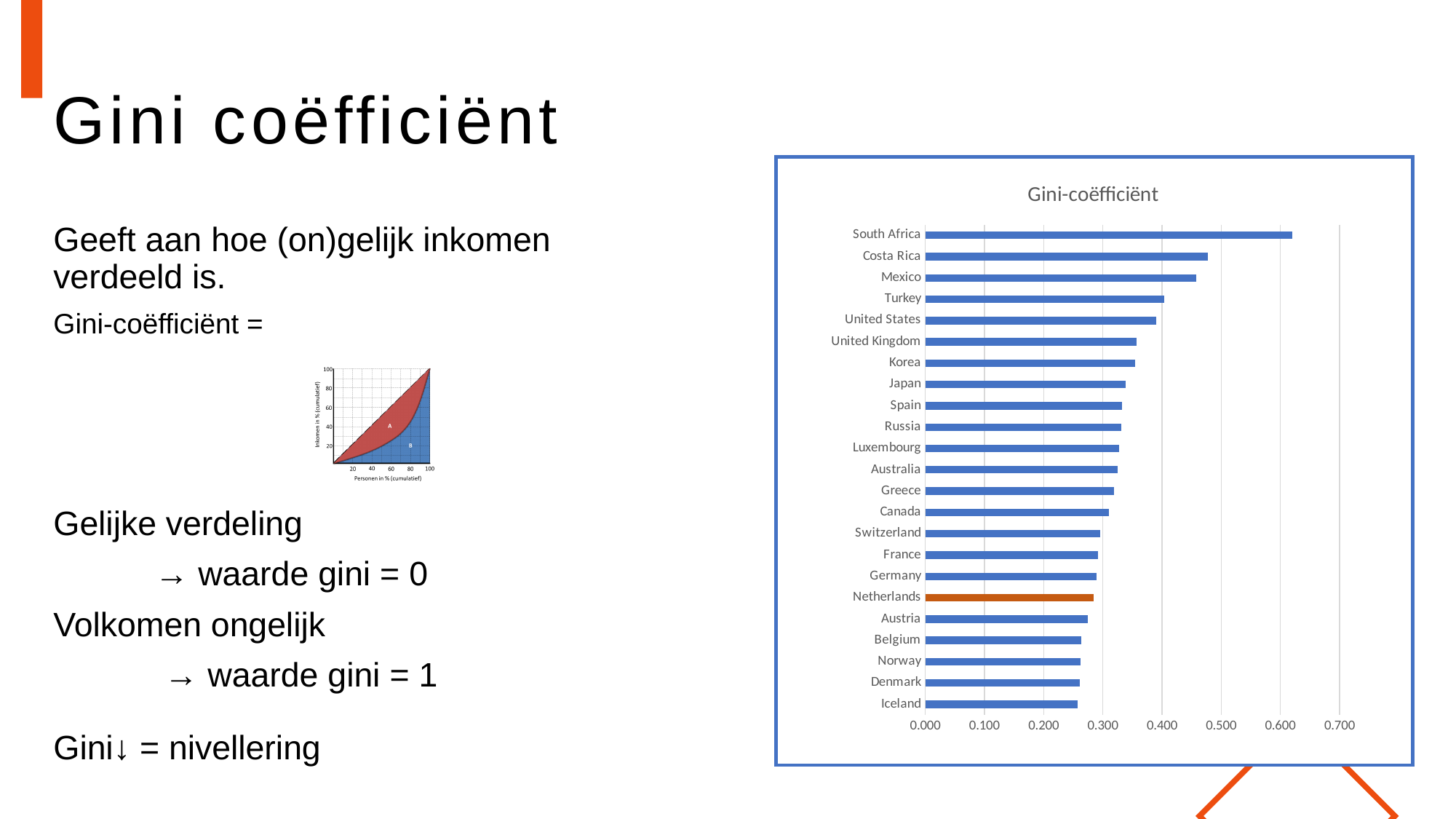
Is the value for South Africa greater or less than 0.500? greater Is the value for United States greater or less than 0.300? greater How many countries are shown in the chart? 23 Is the value for Mexico greater or less than 0.400? greater Do the values in the chart increase or decrease going from the top country to the bottom country? decrease What kind of chart is shown on the slide? bar chart Which has a higher Gini coefficient, Mexico or Germany? Mexico Which country has the highest Gini coefficient in the chart? South Africa Which country's bar is shown in a different colour (orange) from the others? Netherlands What is the title of the chart on the slide? Gini-coëfficiënt